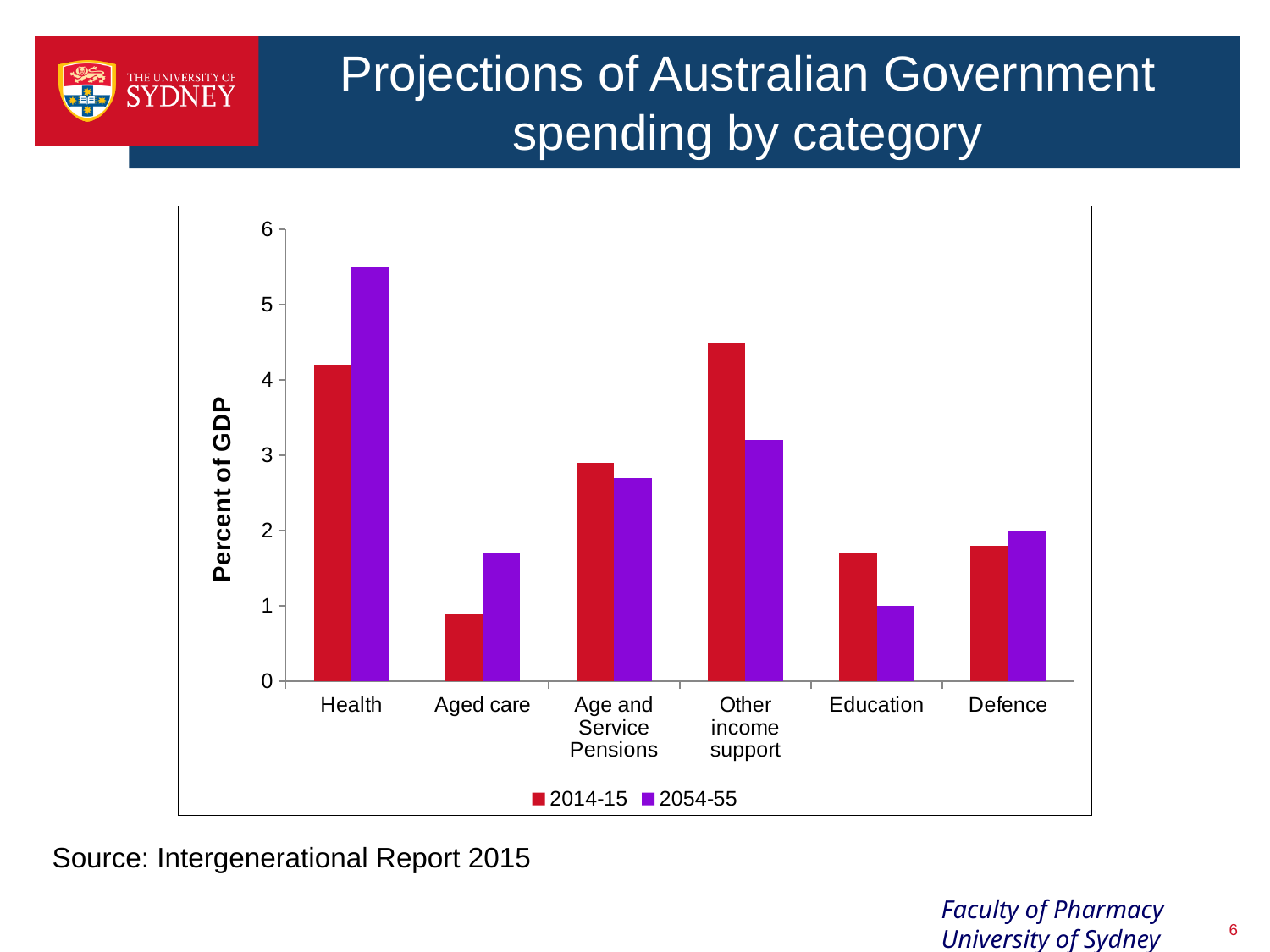
Is the 2014-15 value for Aged care greater or less than 1? less For Other income support, which is larger: the 2014-15 value or the 2054-55 value? 2014-15 Which category has the highest 2014-15 value? Other income support Is the 2014-15 value for Other income support greater or less than 4? greater How many spending categories are shown on the x axis? 6 Which category has the lowest 2014-15 value? Aged care What kind of chart is shown on the slide? bar chart Which category has the highest 2054-55 value? Health For Aged care, which is larger: the 2014-15 value or the 2054-55 value? 2054-55 How many series does the legend list? 2 Is the 2054-55 value for Health greater or less than 5? greater What is the label on the y axis? Percent of GDP